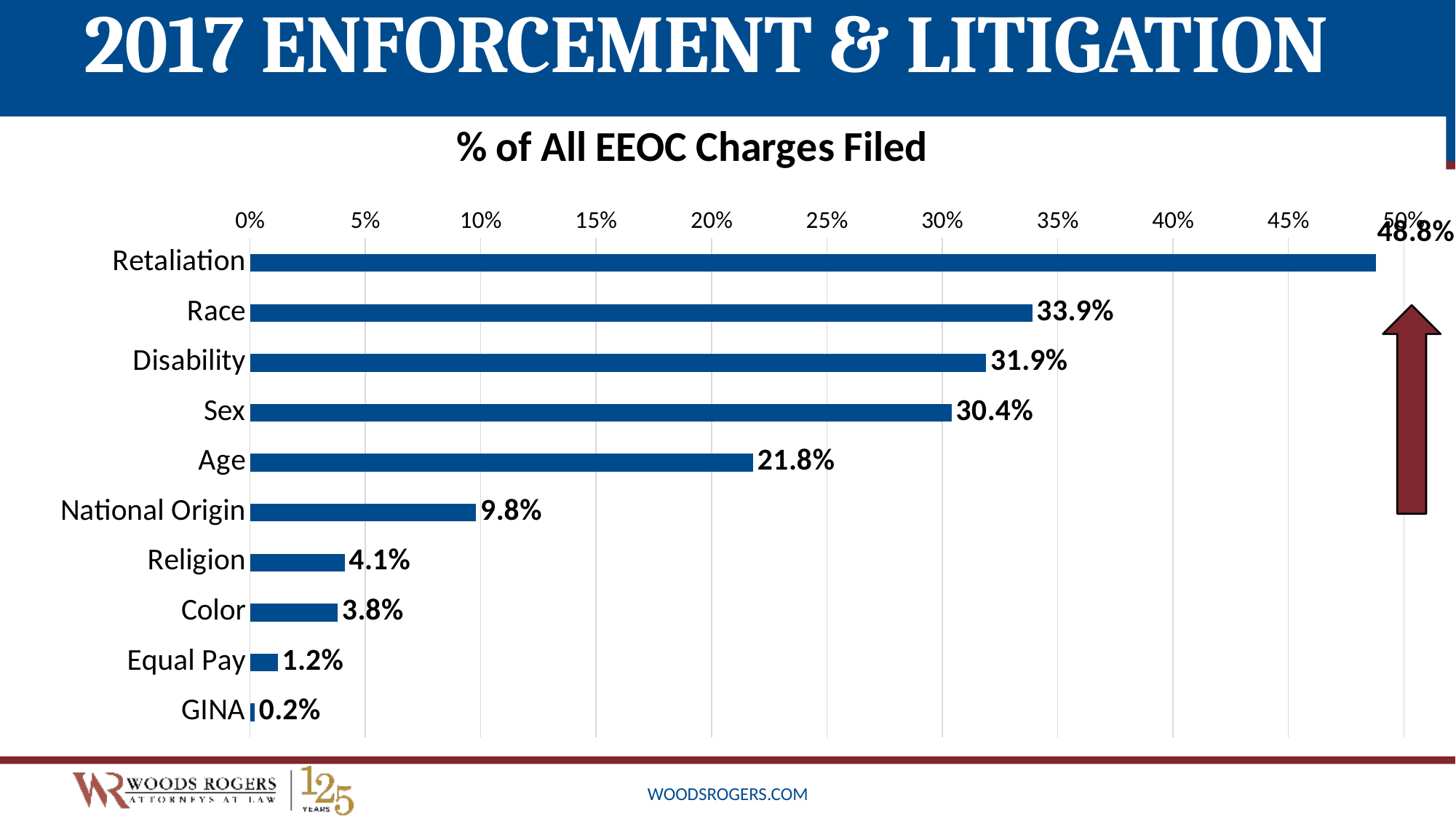
What is the difference between the Race and Sex percentages? 3.5% Which is larger, the value for Age or the value for National Origin? Age What type of chart is shown on the slide? Bar chart What is the value shown for Disability? 31.9% What is the title of the chart? % of All EEOC Charges Filed Which category has the highest percentage of EEOC charges filed? Retaliation Which category has the lowest percentage of EEOC charges filed? GINA What is the value for GINA? 0.2% How many categories are shown in the chart? 10 What is the difference between the Religion and Color percentages? 0.3% What percentage is shown for National Origin? 9.8% What percentage of all EEOC charges filed were for Retaliation? 48.8%